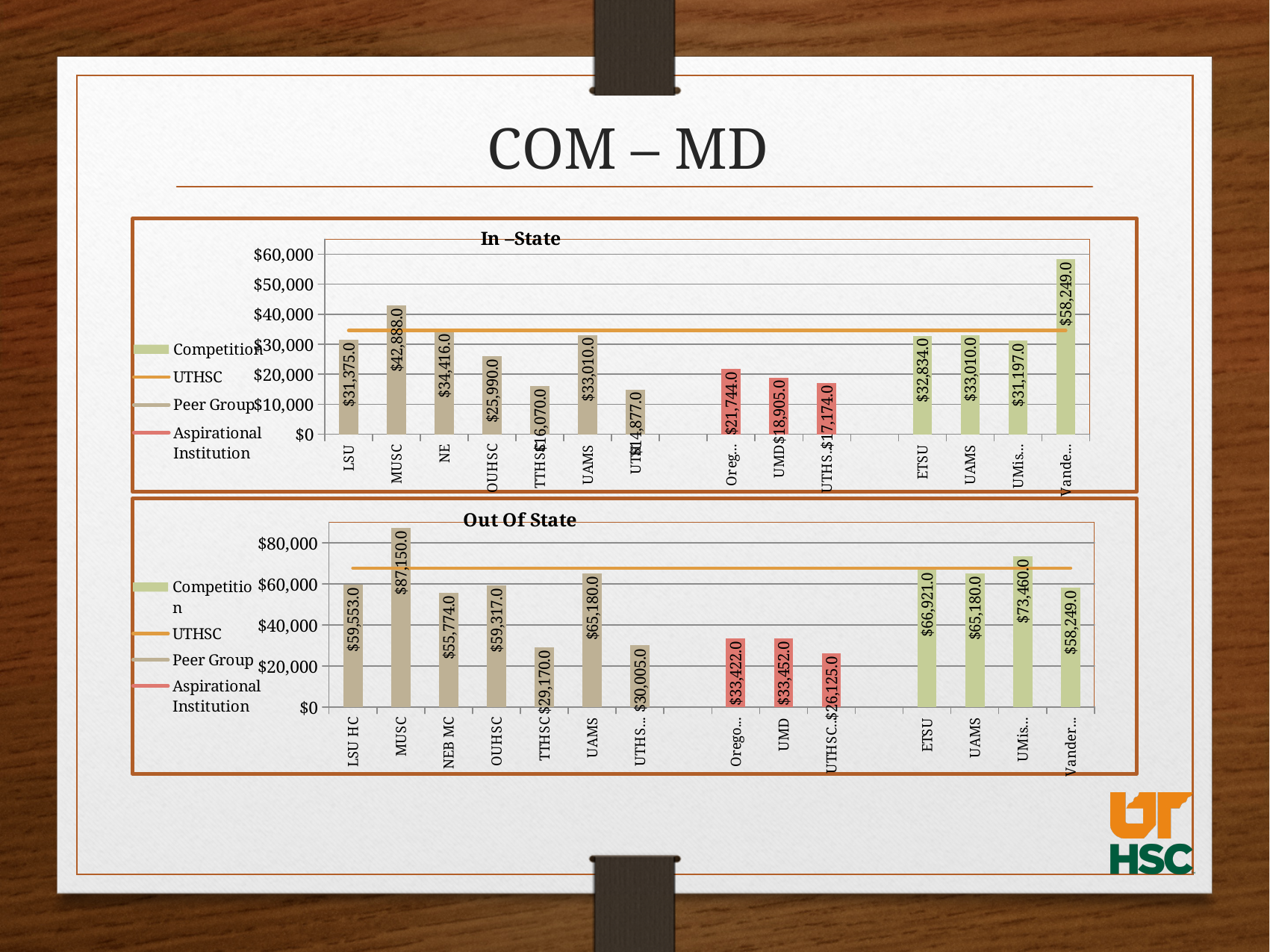
In the Out Of State chart, which is larger, the value for TTHSC or the value for OUHSC? OUHSC In the In –State chart, what is the value for OUHSC? $25,990.0 In the In –State chart, what is the difference between the values for MUSC and LSU? $11,513.0 In the In –State chart, what is the value for MUSC? $42,888.0 In the Out Of State chart, which institution has the highest value? MUSC In the Out Of State chart, what is the difference between the values for UMis... and UAMS? $8,280.0 How many entries does the legend of the Out Of State chart list? 4 In the In –State chart, which institution has the highest value? Vande... In the Out Of State chart, what is the value for ETSU? $66,921.0 In the In –State chart, which is larger, the value for ETSU or the value for UMD? ETSU What kind of chart is the In –State chart? Bar chart In the Out Of State chart, what is the value for MUSC? $87,150.0